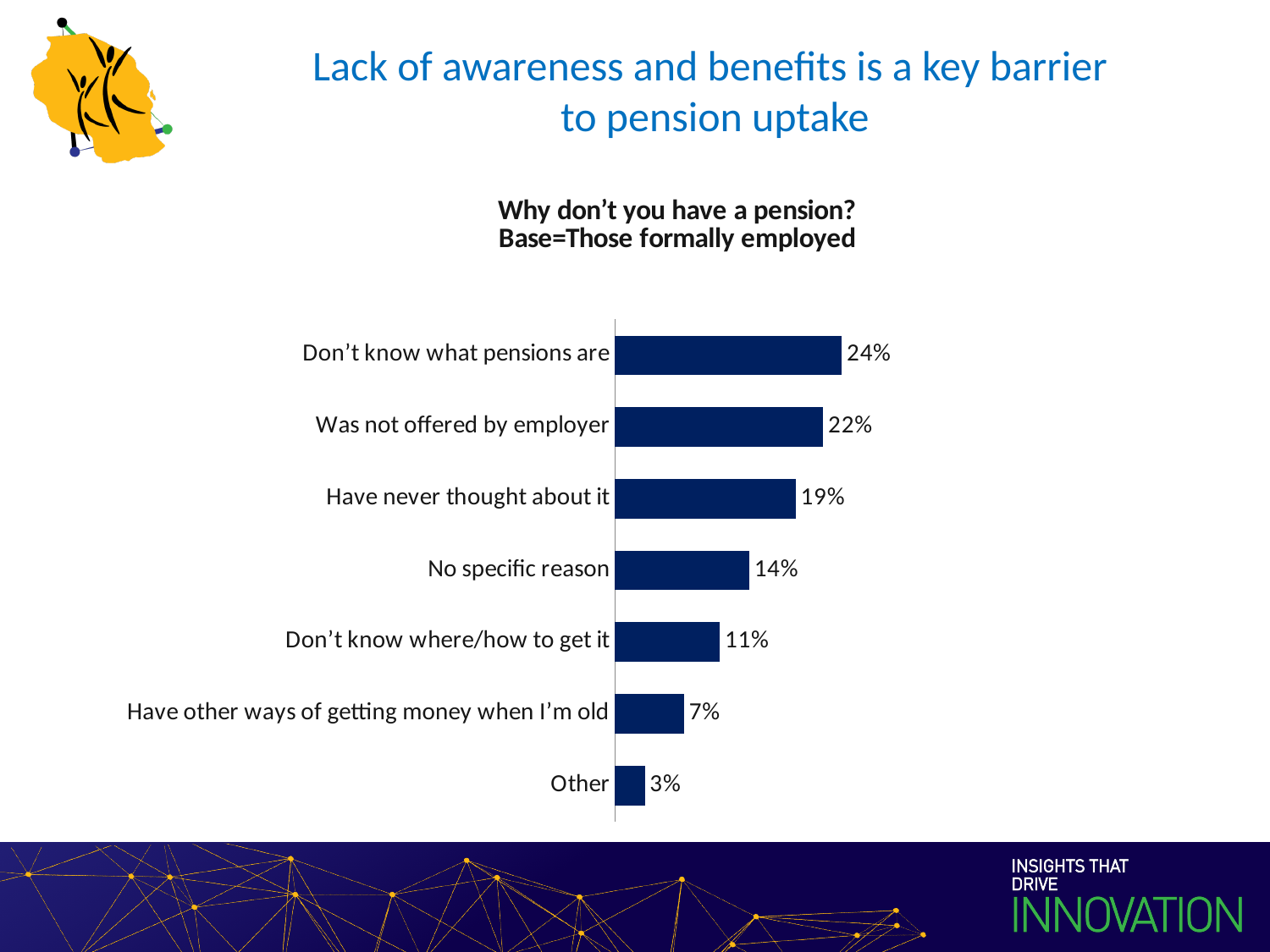
Which reason has the lowest percentage? Other How many reasons are shown in the chart? 7 What is the base of respondents stated in the chart title? Those formally employed What is the difference between 'Don't know what pensions are' and 'Have never thought about it'? 5% What kind of chart is shown on the slide? Bar chart Which is larger: 'Was not offered by employer' or 'Have never thought about it'? Was not offered by employer What percentage of respondents said they don't know what pensions are? 24% What percentage gave 'No specific reason'? 14% What is the difference between 'No specific reason' and 'Don't know where/how to get it'? 3% What is the value for 'Have other ways of getting money when I'm old'? 7% Which reason has the highest percentage? Don't know what pensions are What is the value for 'Was not offered by employer'? 22%